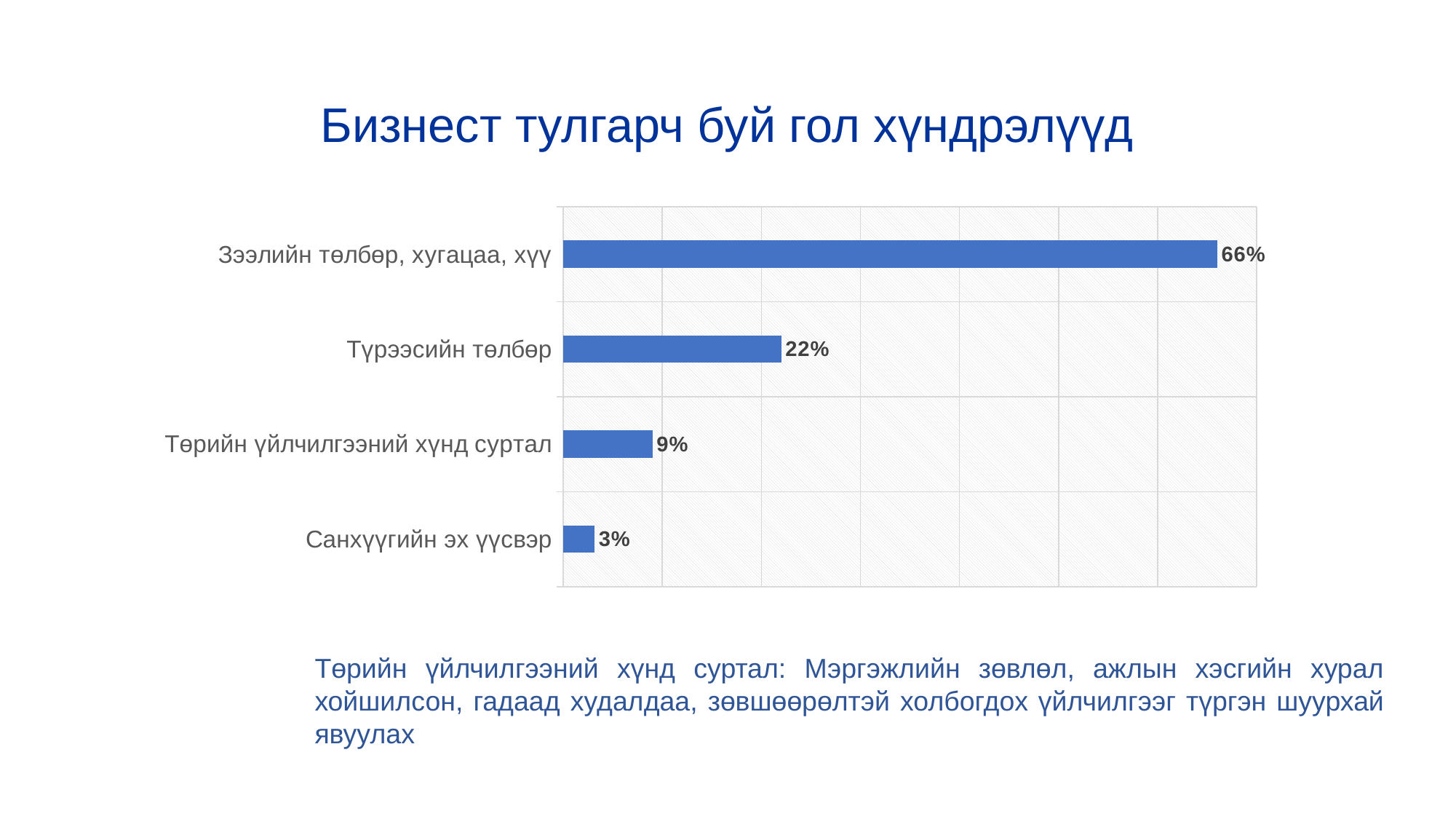
What is the difference between the values for Төрийн үйлчилгээний хүнд суртал and Санхүүгийн эх үүсвэр? 6% Which category has the lowest value? Санхүүгийн эх үүсвэр What is the difference between the values for Зээлийн төлбөр, хугацаа, хүү and Түрээсийн төлбөр? 44% What is the title of the slide? Бизнест тулгарч буй гол хүндрэлүүд What is the value for Санхүүгийн эх үүсвэр? 3% What kind of chart is shown on the slide? Bar chart What is the value for Зээлийн төлбөр, хугацаа, хүү? 66% How many categories are shown in the chart? 4 What is the value for Түрээсийн төлбөр? 22% Which is larger, the value for Түрээсийн төлбөр or the value for Төрийн үйлчилгээний хүнд суртал? Түрээсийн төлбөр What is the value for Төрийн үйлчилгээний хүнд суртал? 9% Which category has the highest value? Зээлийн төлбөр, хугацаа, хүү